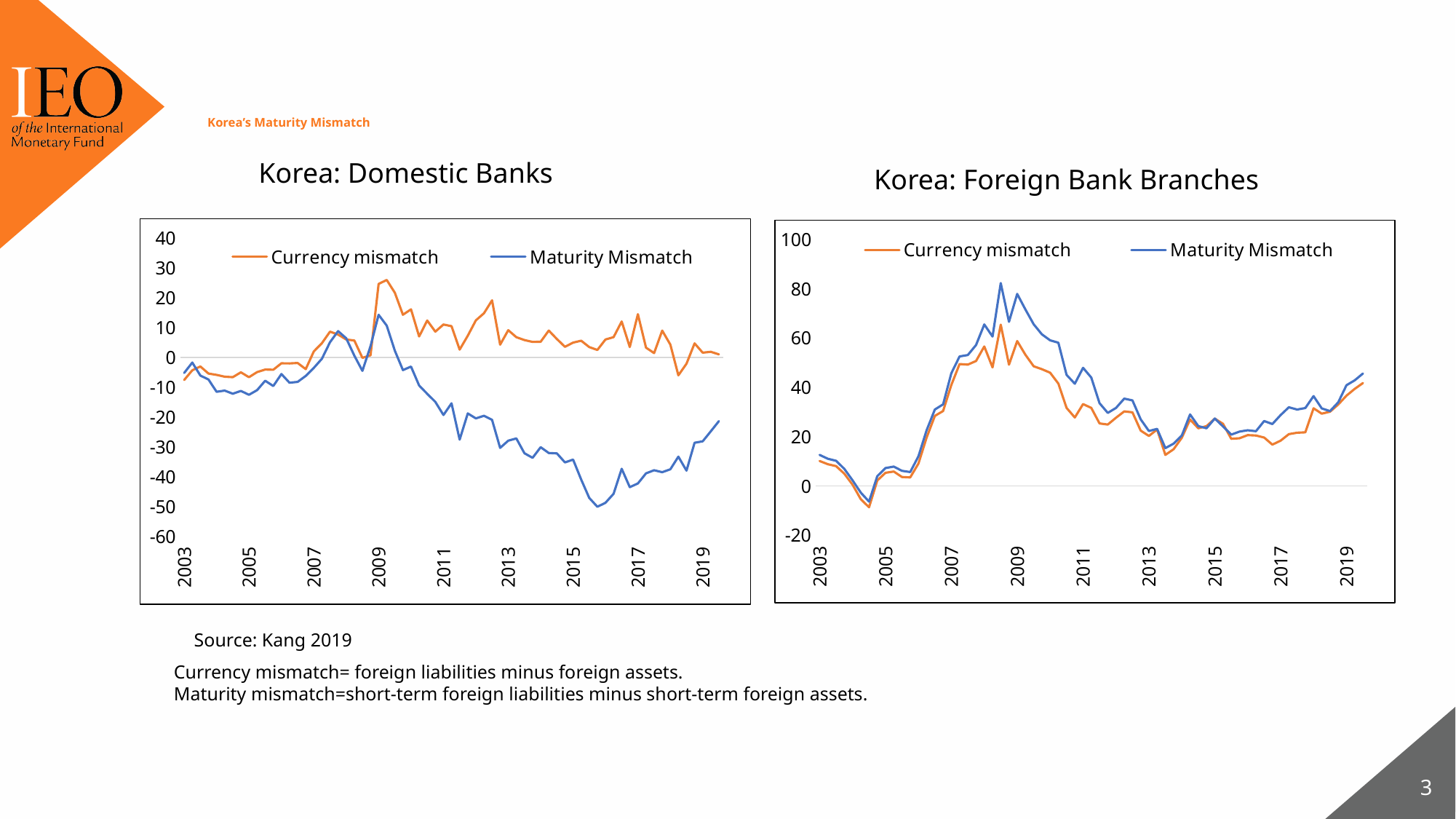
In the 'Korea: Foreign Bank Branches' chart, which series reaches the higher peak around 2008-2009, Currency mismatch or Maturity Mismatch? Maturity Mismatch What kind of chart is the 'Korea: Foreign Bank Branches' chart? Line chart In the 'Korea: Domestic Banks' chart, does the Maturity Mismatch series generally rise or fall between 2009 and 2015? Fall In the 'Korea: Foreign Bank Branches' chart, is the peak Maturity Mismatch value around 2008-2009 greater or less than 60? greater In the 'Korea: Domestic Banks' chart, which series has the higher value in 2017, Currency mismatch or Maturity Mismatch? Currency mismatch In the 'Korea: Domestic Banks' chart, which series is drawn in orange? Currency mismatch In the 'Korea: Foreign Bank Branches' chart, which series is drawn in blue? Maturity Mismatch What kind of chart is the 'Korea: Domestic Banks' chart? Line chart In the 'Korea: Domestic Banks' chart, is the peak Currency mismatch value around 2009 greater or less than 20? greater How many series does the legend of the 'Korea: Domestic Banks' chart list? 2 In the 'Korea: Domestic Banks' chart, is the Maturity Mismatch value in 2013 greater or less than 0? less